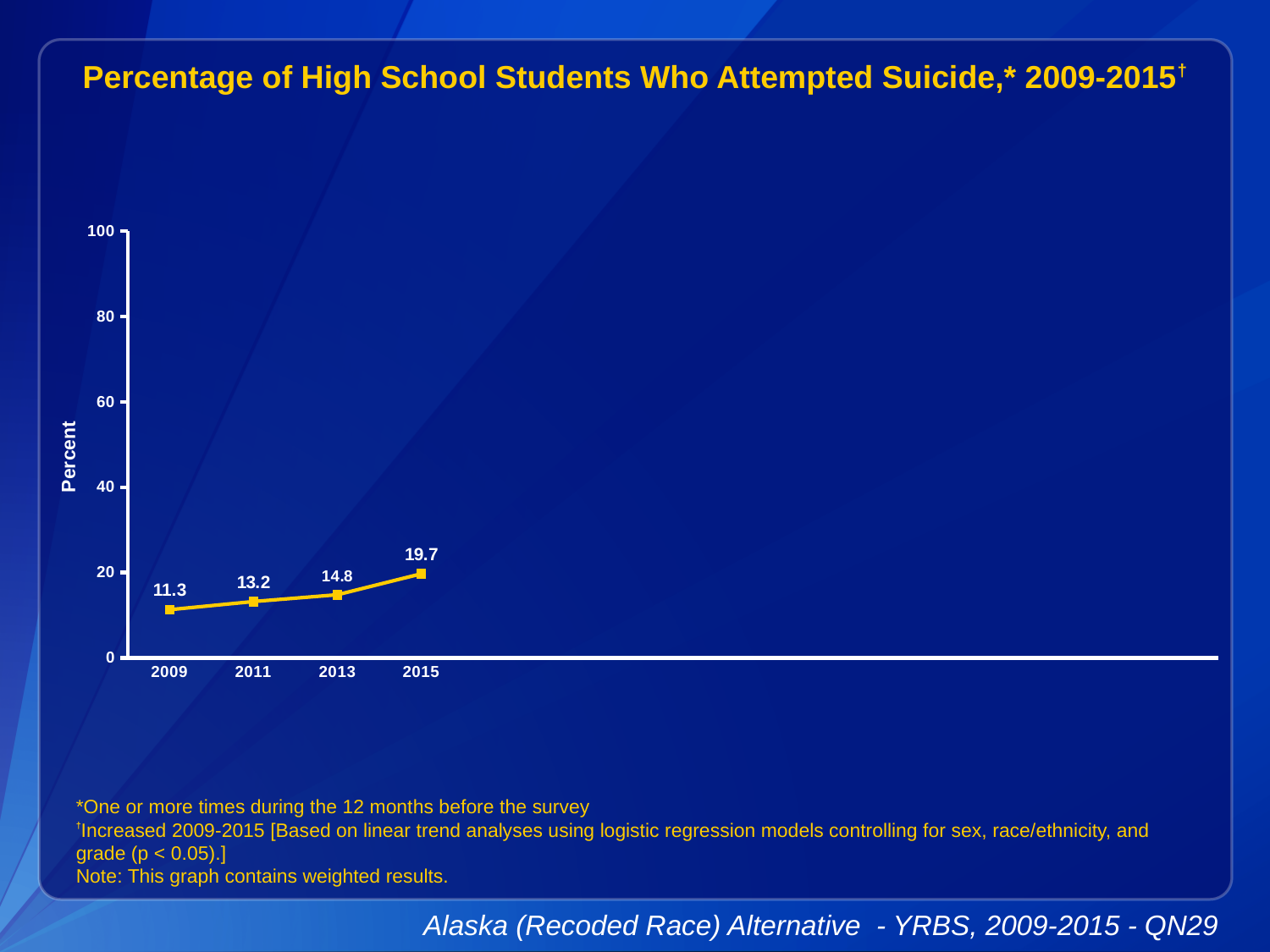
What is the difference between the values for 2015 and 2009? 8.4 What kind of chart is shown? line chart Which is larger, the value for 2013 or the value for 2011? 2013 Do the values rise or fall from 2009 to 2015? rise Which year has the highest value? 2015 Is the value for 2015 greater or less than 40? less What is the value for 2011? 13.2 How many years are plotted on the chart? 4 What is the value for 2015? 19.7 What is the value for 2009? 11.3 What is the difference between the values for 2013 and 2011? 1.6 Which year has the lowest value? 2009